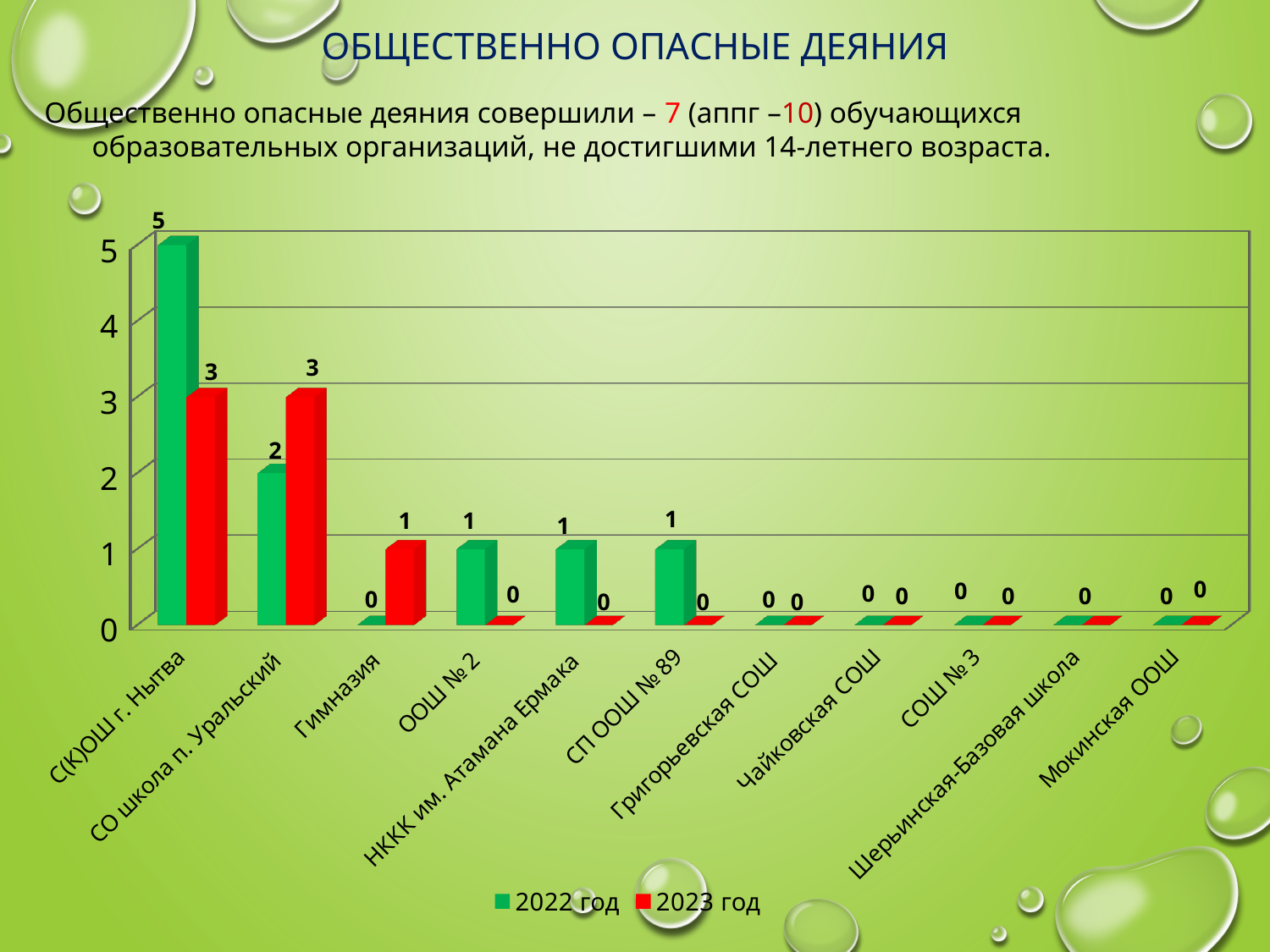
How many categories are shown on the x axis of the chart? 11 For СО школа п. Уральский, which series has the larger value, 2022 год or 2023 год? 2023 год What is the difference between the 2022 год and 2023 год values for С(К)ОШ г. Нытва? 2 What is the value for ООШ № 2 in the 2022 год series? 1 What is the value for Гимназия in the 2023 год series? 1 How many series does the legend list? 2 What is the value for СП ООШ № 89 in the 2023 год series? 0 What is the value for С(К)ОШ г. Нытва in the 2022 год series? 5 What is the value for СО школа п. Уральский in the 2023 год series? 3 Which colour represents the 2023 год series in the chart? red What kind of chart is shown on the slide? bar chart Which category has the highest value in the 2022 год series? С(К)ОШ г. Нытва